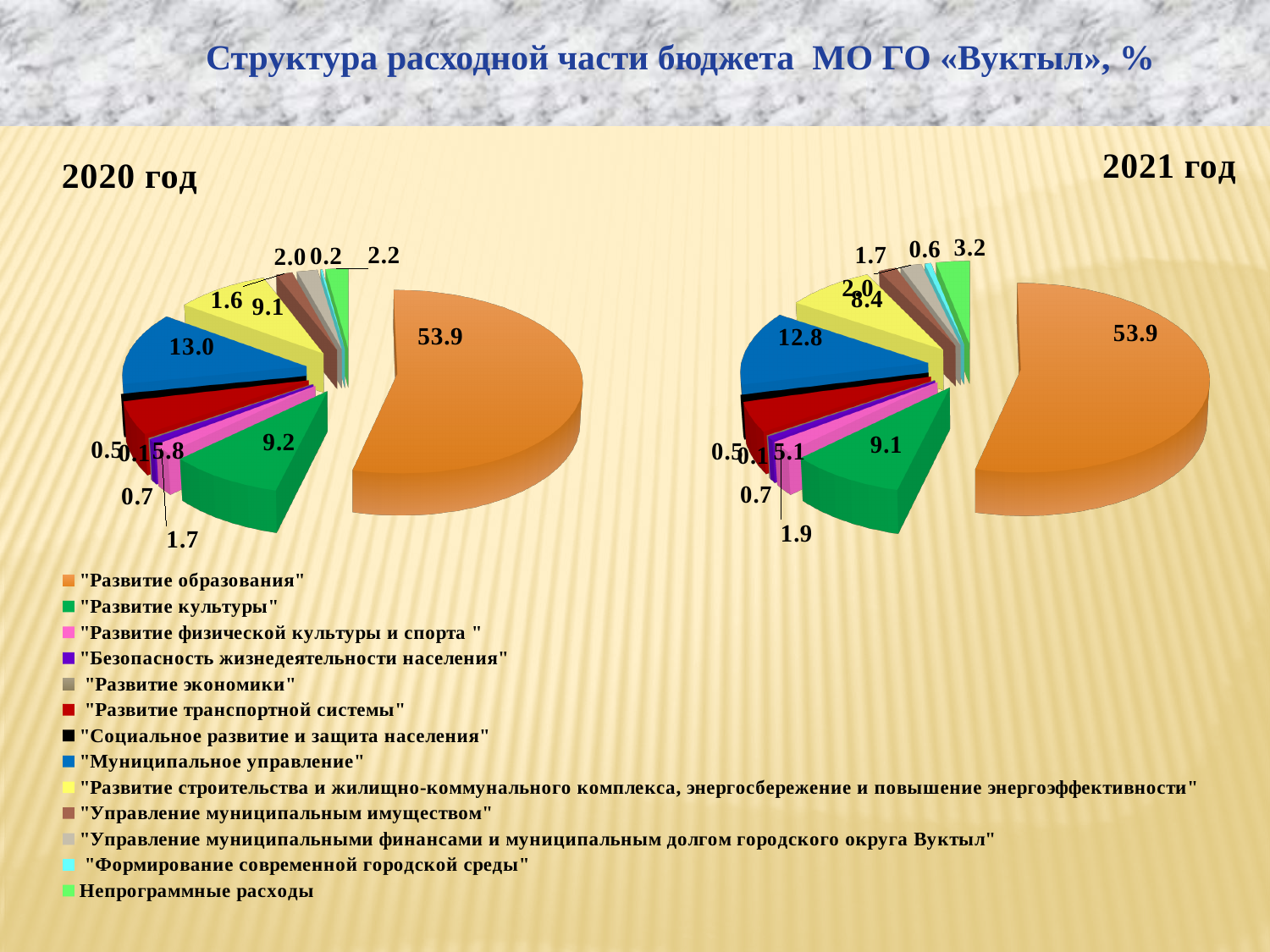
In the 2021 год pie chart, what is the value for "Муниципальное управление"? 12.8 In the 2020 год pie chart, which category has the largest share? "Развитие образования" What is the difference between the "Муниципальное управление" value in the 2020 год chart and in the 2021 год chart? 0.2 What kind of chart is used on this slide for the 2020 год and 2021 год data? pie chart In the 2020 год pie chart, what is the value for "Развитие образования"? 53.9 In the 2020 год pie chart, what is the value for "Муниципальное управление"? 13.0 In the 2021 год pie chart, which is larger: "Развитие культуры" or "Развитие строительства и жилищно-коммунального комплекса, энергосбережение и повышение энергоэффективности"? "Развитие культуры" In the 2021 год pie chart, what is the value for "Развитие строительства и жилищно-коммунального комплекса, энергосбережение и повышение энергоэффективности"? 8.4 How many categories does the legend list for the pie charts? 13 In the 2021 год pie chart, what is the value for "Развитие образования"? 53.9 In the 2021 год pie chart, what is the value for "Непрограммные расходы"? 3.2 In the 2020 год pie chart, what is the value for "Развитие культуры"? 9.2